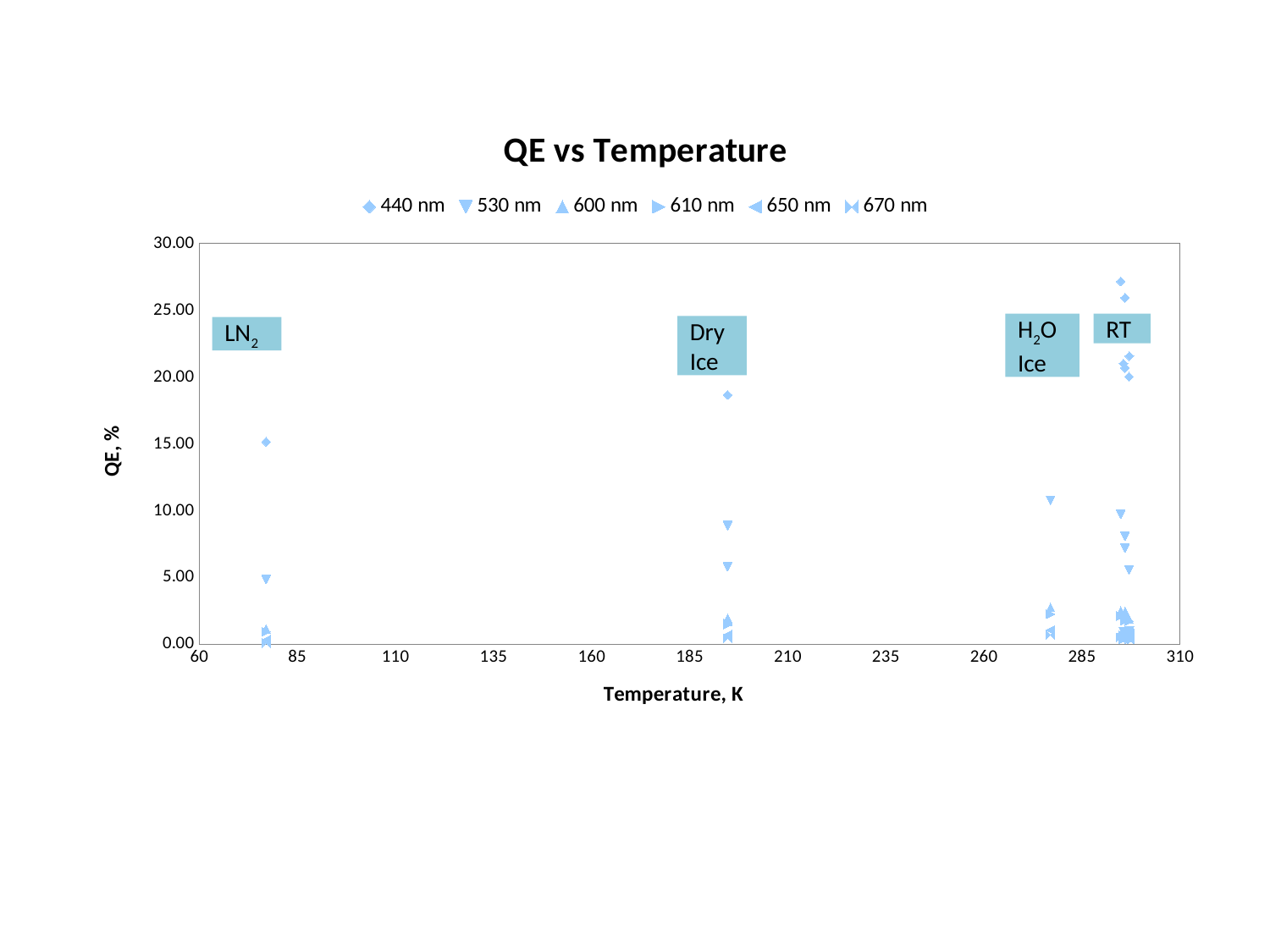
Is the QE value for 530 nm at the LN2 temperature greater or less than 10.00? less What kind of chart is shown on the slide? scatter chart What is the title of the chart? QE vs Temperature Is the highest QE value for 440 nm at RT greater or less than 25.00? greater At the Dry Ice temperature, which series has the higher QE: 440 nm or 530 nm? 440 nm Is the QE value for 440 nm at the LN2 temperature greater or less than 10.00? greater How many series does the legend list? 6 Do the QE values for the 440 nm series rise or fall as temperature increases? rise How many labelled temperature groups (LN2, Dry Ice, H2O Ice, RT) are marked on the chart? 4 What is the label on the x axis? Temperature, K